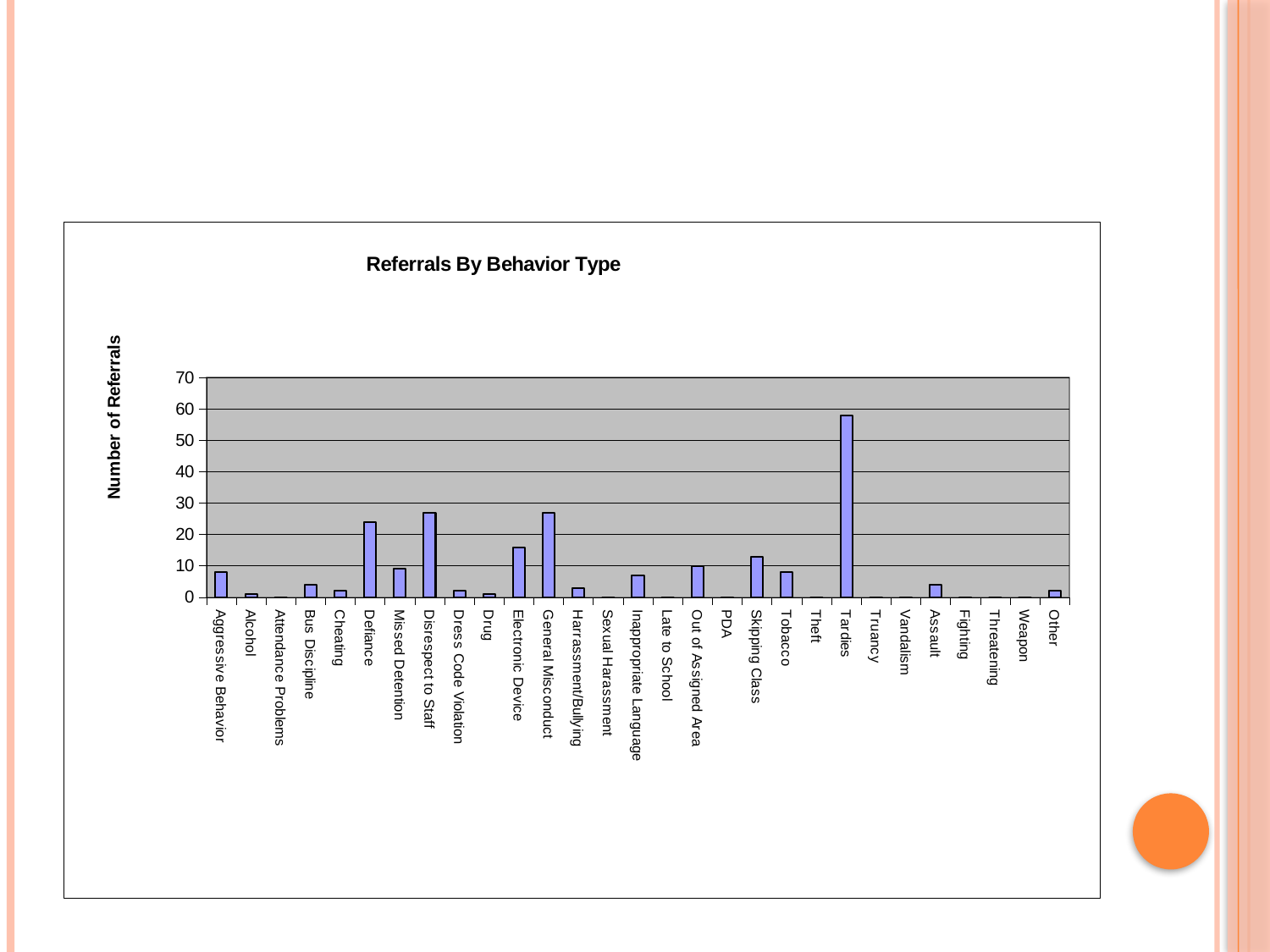
Is the value for Disrespect to Staff greater or less than 30? less Is the value for Aggressive Behavior greater or less than 10? less How many behavior type categories are shown on the x axis? 29 Which has more referrals, Skipping Class or Bus Discipline? Skipping Class Which behavior type has the highest number of referrals? Tardies What is the title of the chart? Referrals By Behavior Type What is the label on the vertical axis of the chart? Number of Referrals Is the value for Tardies greater or less than 50? greater Which has more referrals, Defiance or Electronic Device? Defiance What type of chart is shown on the slide? bar chart